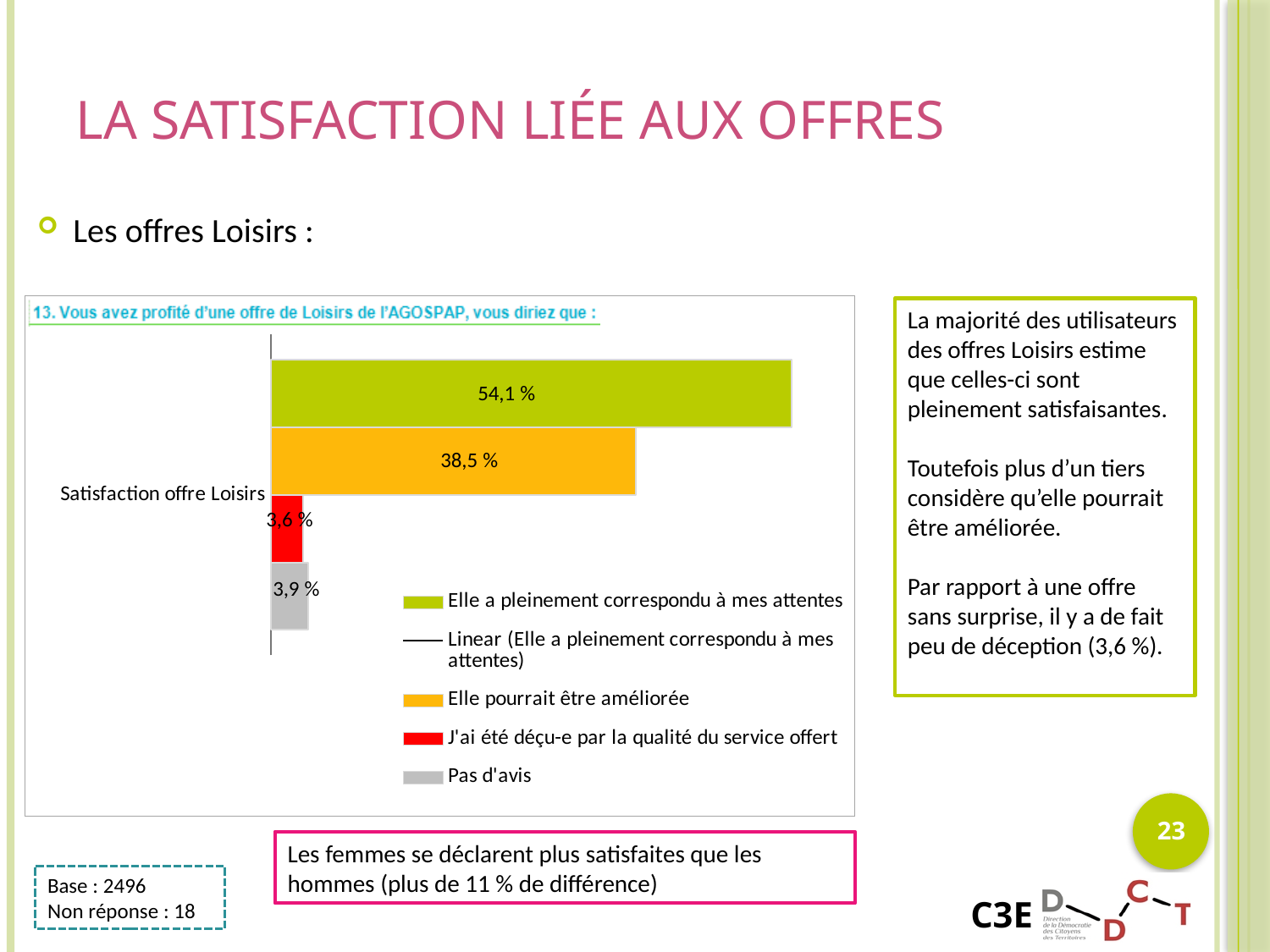
Which is larger: "Elle pourrait être améliorée" or "Pas d'avis"? Elle pourrait être améliorée What is the difference between "Elle a pleinement correspondu à mes attentes" and "Elle pourrait être améliorée"? 15,6 % What is the category label shown on the vertical axis of the chart? Satisfaction offre Loisirs How many entries does the chart legend list? 5 What kind of chart is shown on the slide? Bar chart What is the value for "J'ai été déçu-e par la qualité du service offert"? 3,6 % Which response has the lowest value? J'ai été déçu-e par la qualité du service offert What is the value for "Elle a pleinement correspondu à mes attentes"? 54,1 % What colour is the bar for "Elle pourrait être améliorée"? Orange What is the value for "Elle pourrait être améliorée"? 38,5 % What is the value for "Pas d'avis"? 3,9 % Which response has the highest value? Elle a pleinement correspondu à mes attentes